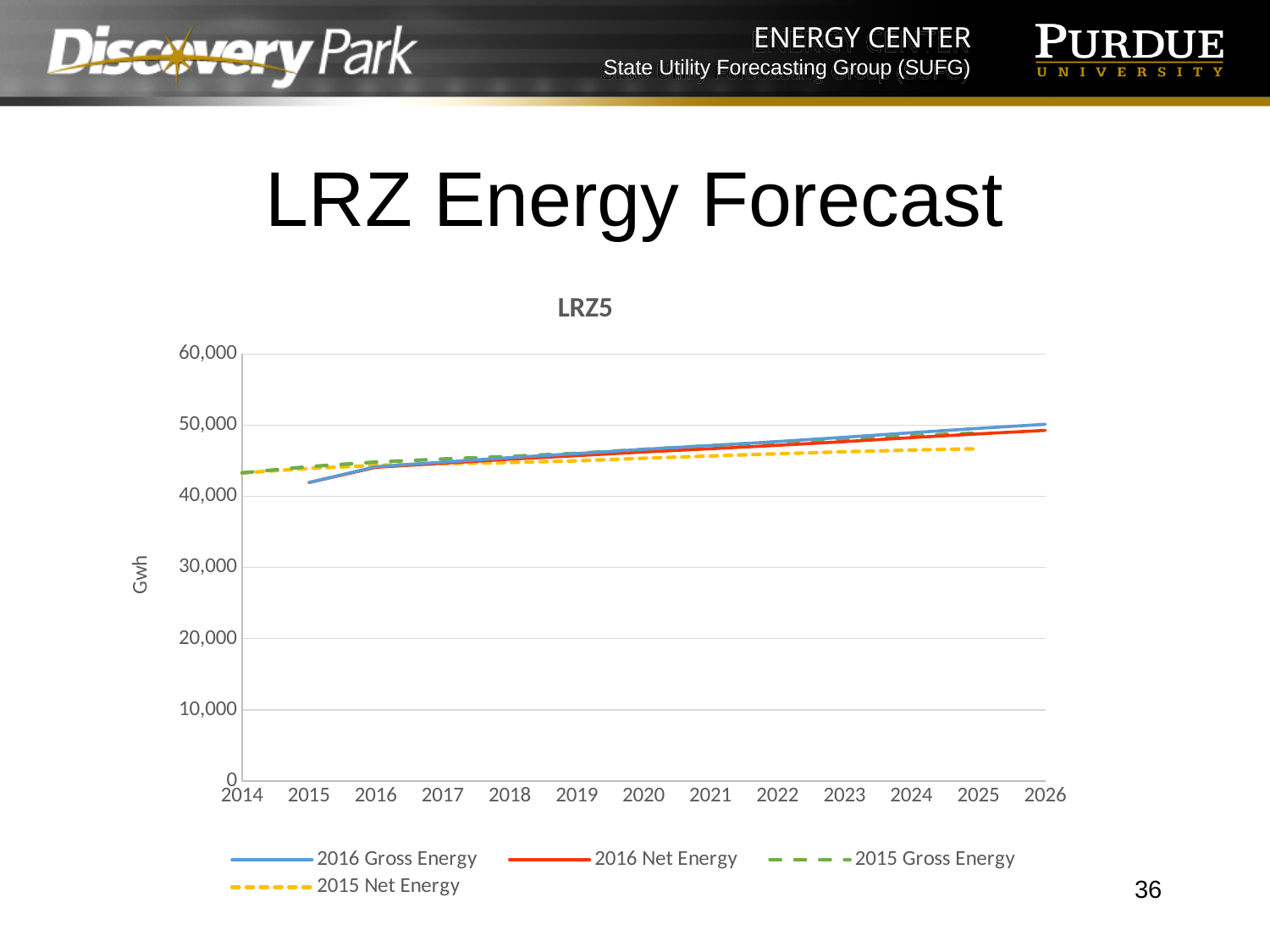
Is the 2015 Gross Energy value in 2014 greater or less than 40,000? greater How many series does the legend of the LRZ5 chart list? 4 Is the 2016 Net Energy value in 2026 greater or less than 60,000? less Do the 2016 Gross Energy values rise or fall from 2015 to 2026? rise What is the label on the vertical axis of the chart? Gwh What is the title of the chart? LRZ5 How many years are marked on the x axis of the chart? 13 In 2024, which is larger: 2015 Gross Energy or 2015 Net Energy? 2015 Gross Energy Do the 2015 Net Energy values rise or fall across the years shown? rise Is the 2016 Gross Energy value in 2015 greater or less than 40,000? greater What kind of chart is shown on the slide? line chart